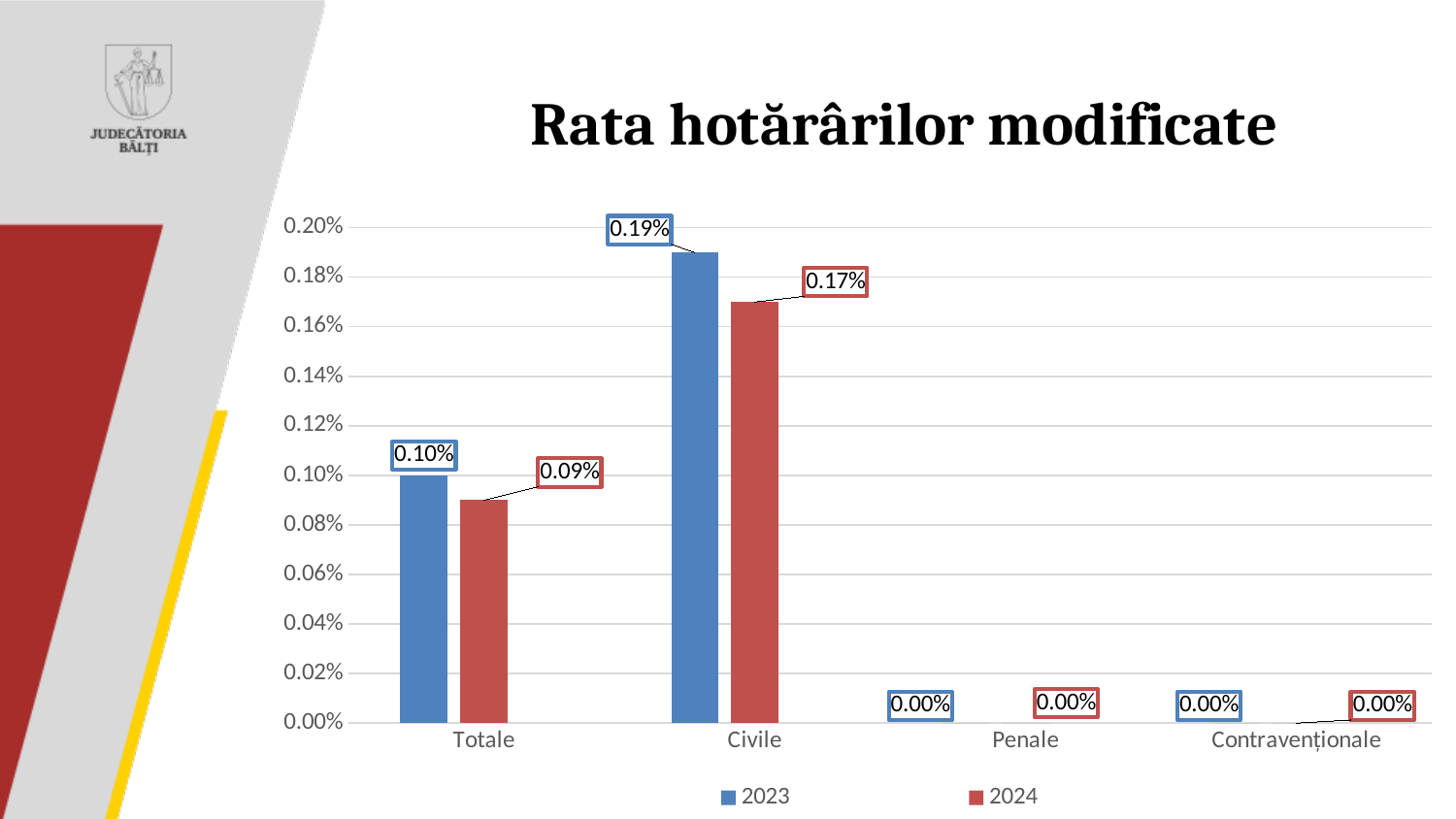
Which category has the highest value for 2023? Civile What is the value for Penale in 2023? 0.00% What is the value for Civile in 2024? 0.17% What is the difference between the 2023 and 2024 values for Totale? 0.01% Which is larger for Totale, the 2023 value or the 2024 value? 2023 What is the title of the chart? Rata hotărârilor modificate What kind of chart is shown on the slide? Bar chart What is the difference between the 2023 and 2024 values for Civile? 0.02% How many categories are shown on the x axis? 4 How many series does the legend list? 2 What is the value for Totale in 2024? 0.09% What is the value for Civile in 2023? 0.19%